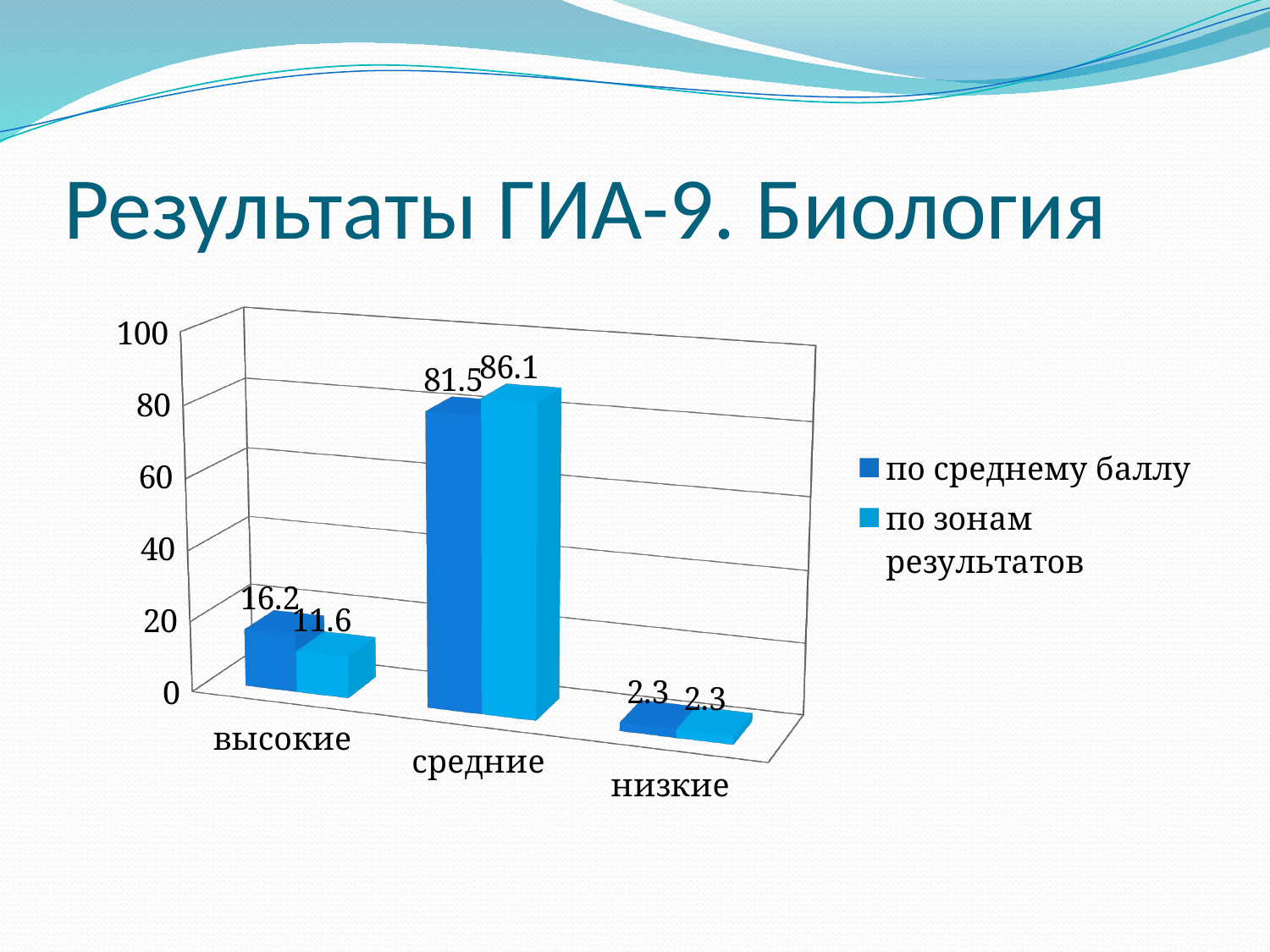
Is the value for "средние" in the "по среднему баллу" series greater or less than 60? greater For "высокие", which series has the larger value: "по среднему баллу" or "по зонам результатов"? по среднему баллу What is the value for "высокие" in the "по среднему баллу" series? 16.2 What is the difference between the "по зонам результатов" and "по среднему баллу" values for "средние"? 4.6 How many categories are shown on the x axis? 3 What is the value for "средние" in the "по зонам результатов" series? 86.1 How many series does the legend list? 2 Which category has the lowest value in the "по зонам результатов" series? низкие Which category has the highest value in the "по среднему баллу" series? средние What type of chart is shown on the slide? bar chart What is the difference between the "по среднему баллу" and "по зонам результатов" values for "высокие"? 4.6 What is the value for "низкие" in the "по среднему баллу" series? 2.3